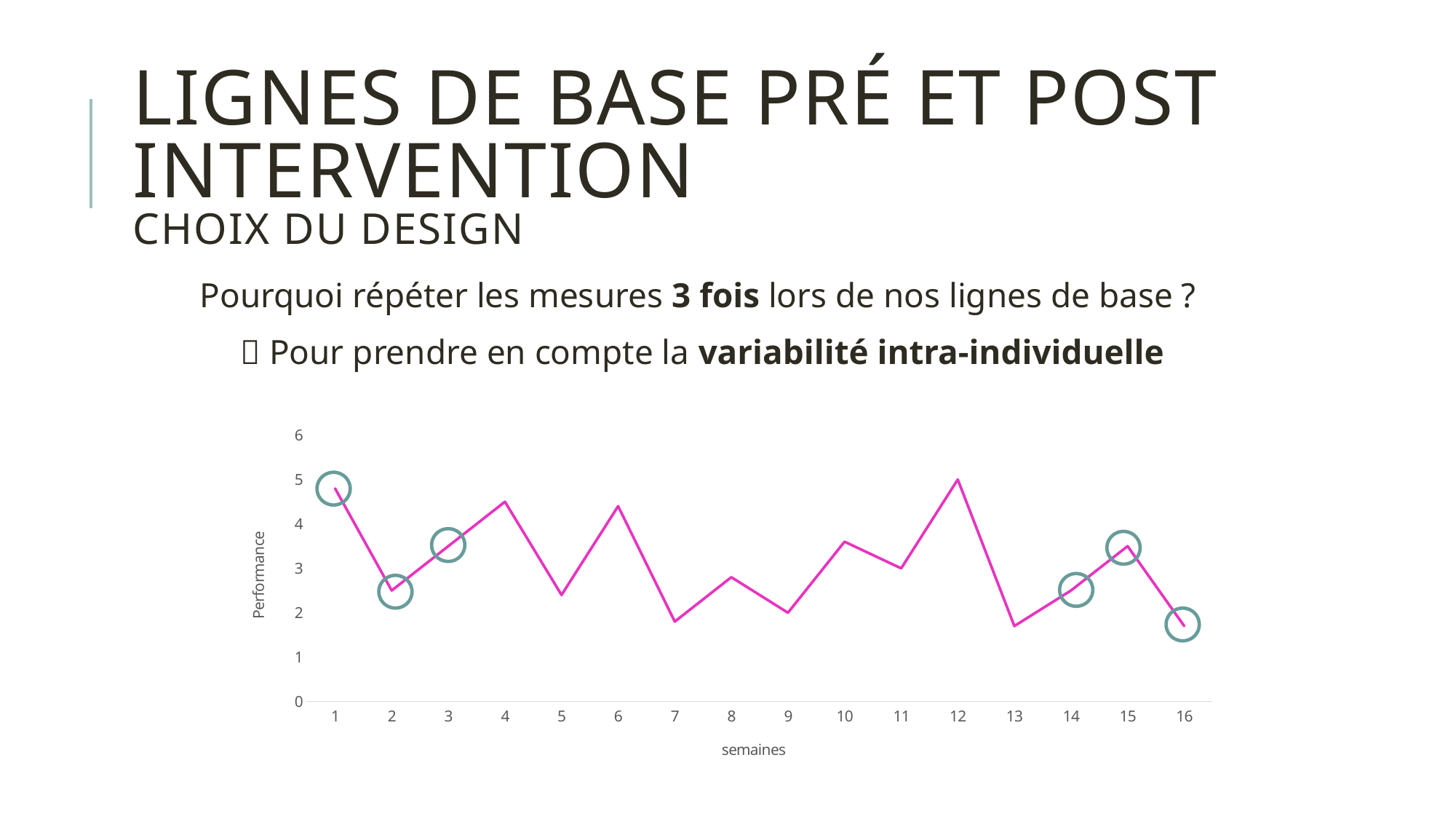
Which has the higher performance value, week 12 or week 13? week 12 Is the performance value for week 9 greater or less than 3? less Is the performance value for week 13 greater or less than 2? less Which has the higher performance value, week 1 or week 2? week 1 What is the label of the y axis of the chart? Performance Is the performance value for week 1 greater or less than 4? greater Does the performance value rise or fall from week 12 to week 13? fall How many weeks (data points) are plotted on the x axis of the chart? 16 What kind of chart is shown on the slide? line chart What is the label of the x axis of the chart? semaines